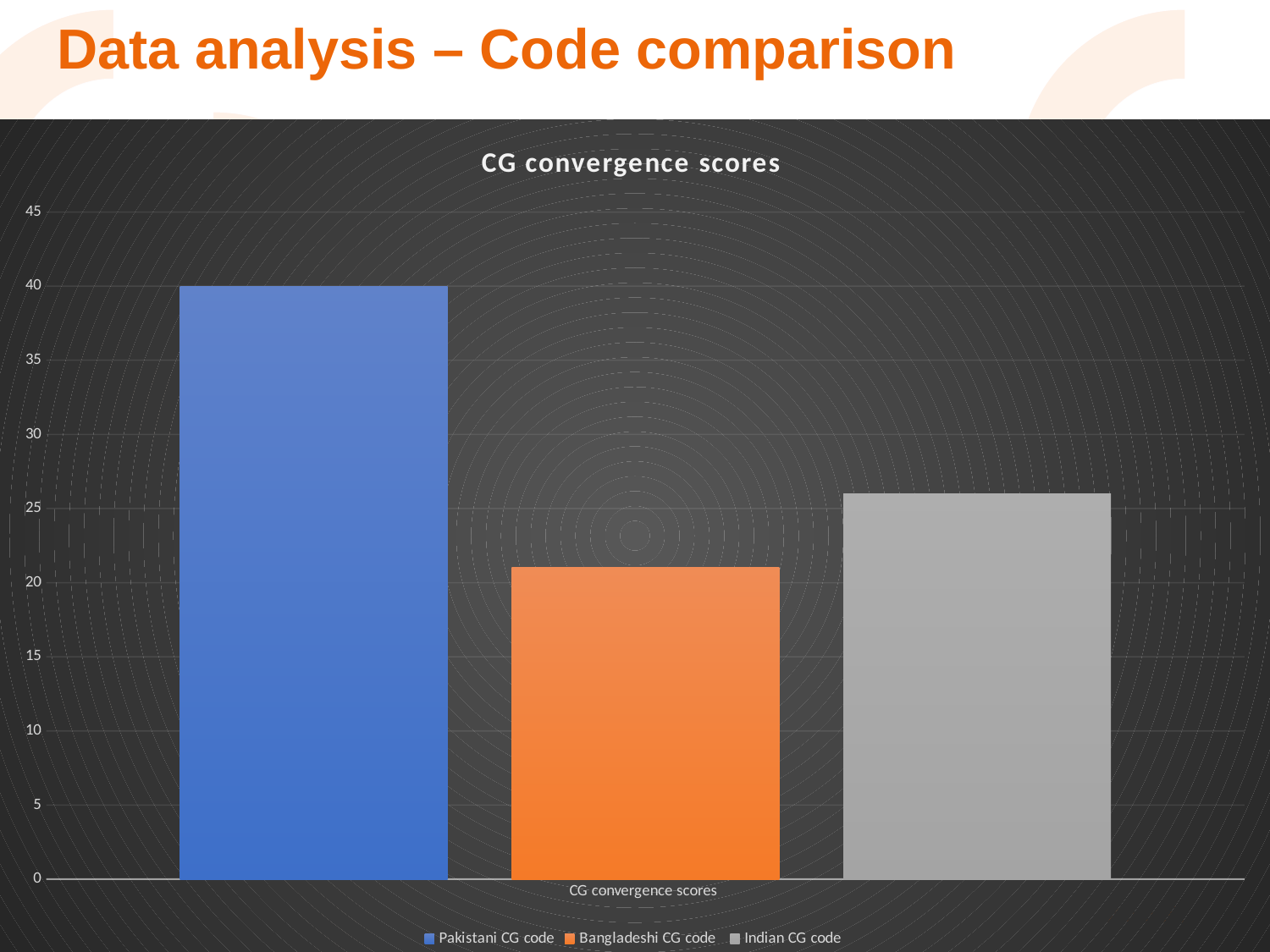
How many series does the legend list? 3 What is the CG convergence score for the Pakistani CG code? 40 What kind of chart is shown on the slide? bar chart Is the value for the Indian CG code greater or less than 30? less What is the title of the chart? CG convergence scores Is the value for the Bangladeshi CG code greater or less than 20? greater Which has a higher CG convergence score, the Indian CG code or the Bangladeshi CG code? Indian CG code Is the value for the Indian CG code greater or less than 25? greater What colour is the bar for the Pakistani CG code? blue Which code has the highest CG convergence score? Pakistani CG code Which code has the lowest CG convergence score? Bangladeshi CG code